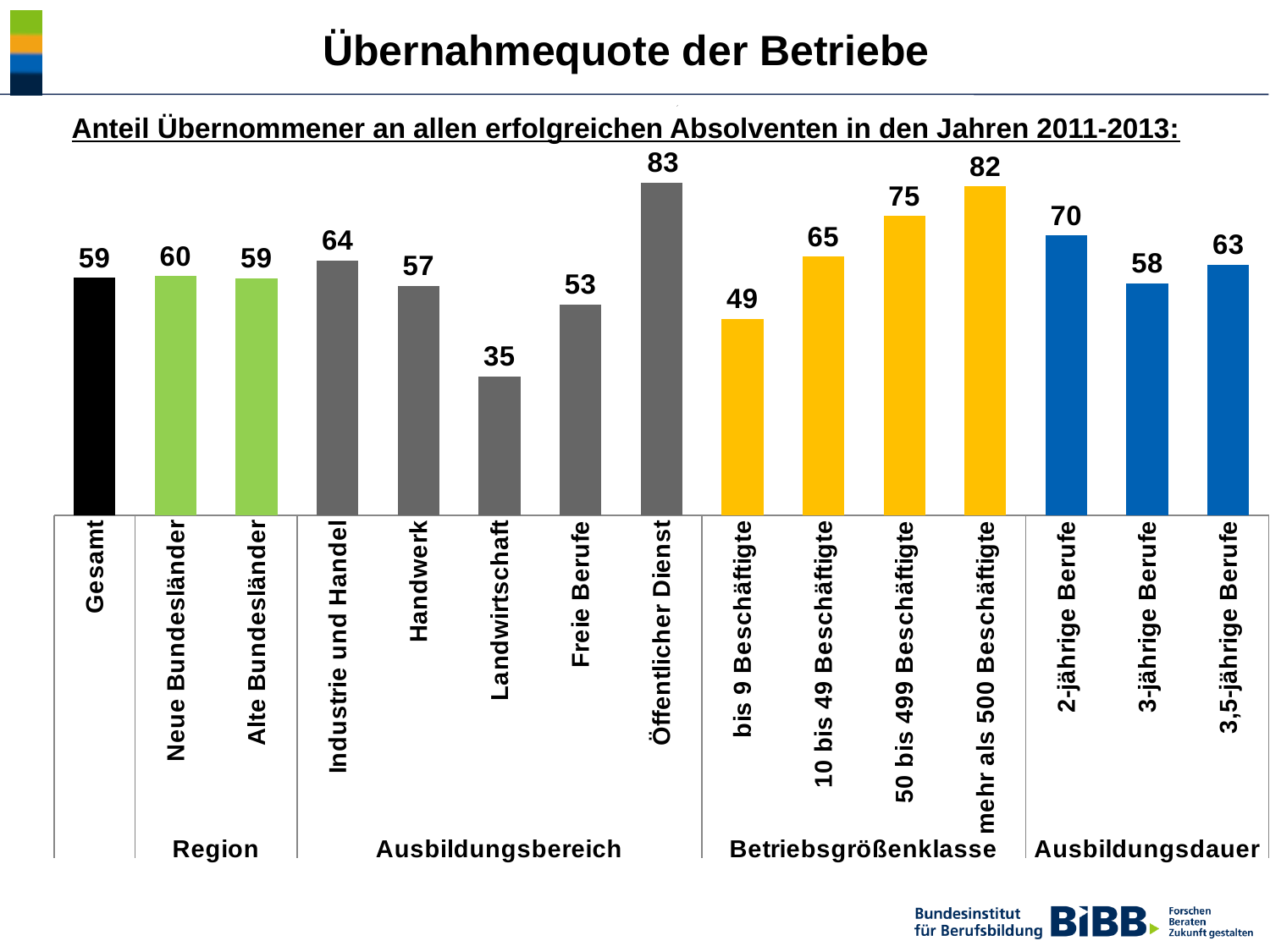
What colour are the bars in the Betriebsgrößenklasse group? Yellow Which is larger, the value for Handwerk or the value for Industrie und Handel? Industrie und Handel What is the value for Gesamt? 59 What is the value for mehr als 500 Beschäftigte? 82 What kind of chart is shown on the slide? Bar chart How many bars are shown in the chart? 15 What is the value for Landwirtschaft? 35 What is the difference between the values for 2-jährige Berufe and 3-jährige Berufe? 12 Which category has the highest value? Öffentlicher Dienst What is the difference between the values for Öffentlicher Dienst and Landwirtschaft? 48 Do the values rise or fall across the Betriebsgrößenklasse group from bis 9 Beschäftigte to mehr als 500 Beschäftigte? Rise Which category has the lowest value? Landwirtschaft